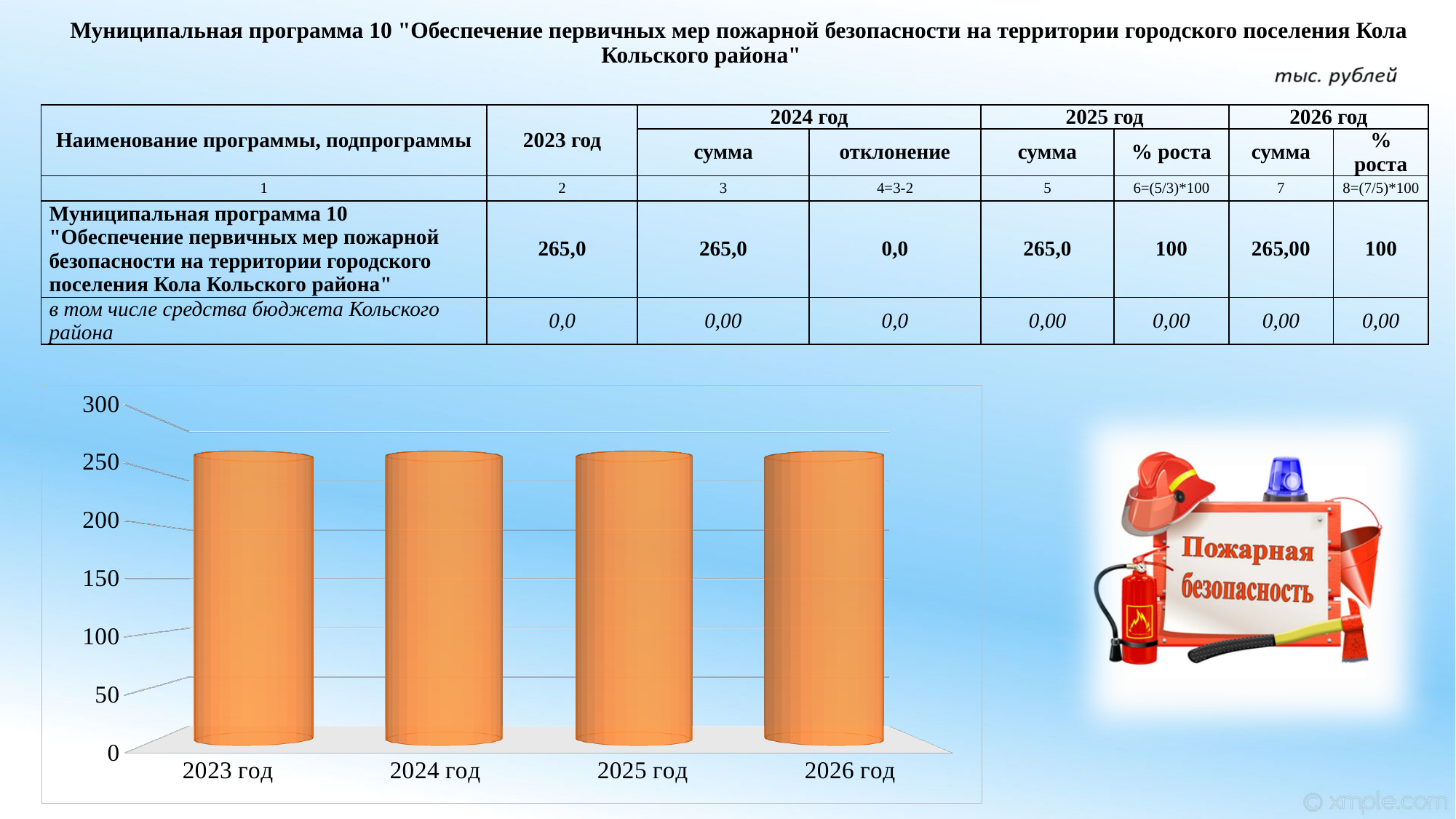
Which year is the first category on the x axis of the chart? 2023 год What is the highest tick value shown on the vertical axis of the chart? 300 Is the value for 2026 год greater or less than 150? greater How many bars (years) does the chart show? 4 What colour are the bars in the chart? orange Is the value for 2023 год greater or less than 200? greater Is the value for 2025 год greater or less than 250? greater Which year is the last category on the x axis of the chart? 2026 год Do the bar values rise, fall, or stay the same from 2023 год to 2026 год? stay the same What kind of chart is shown on the slide? bar chart